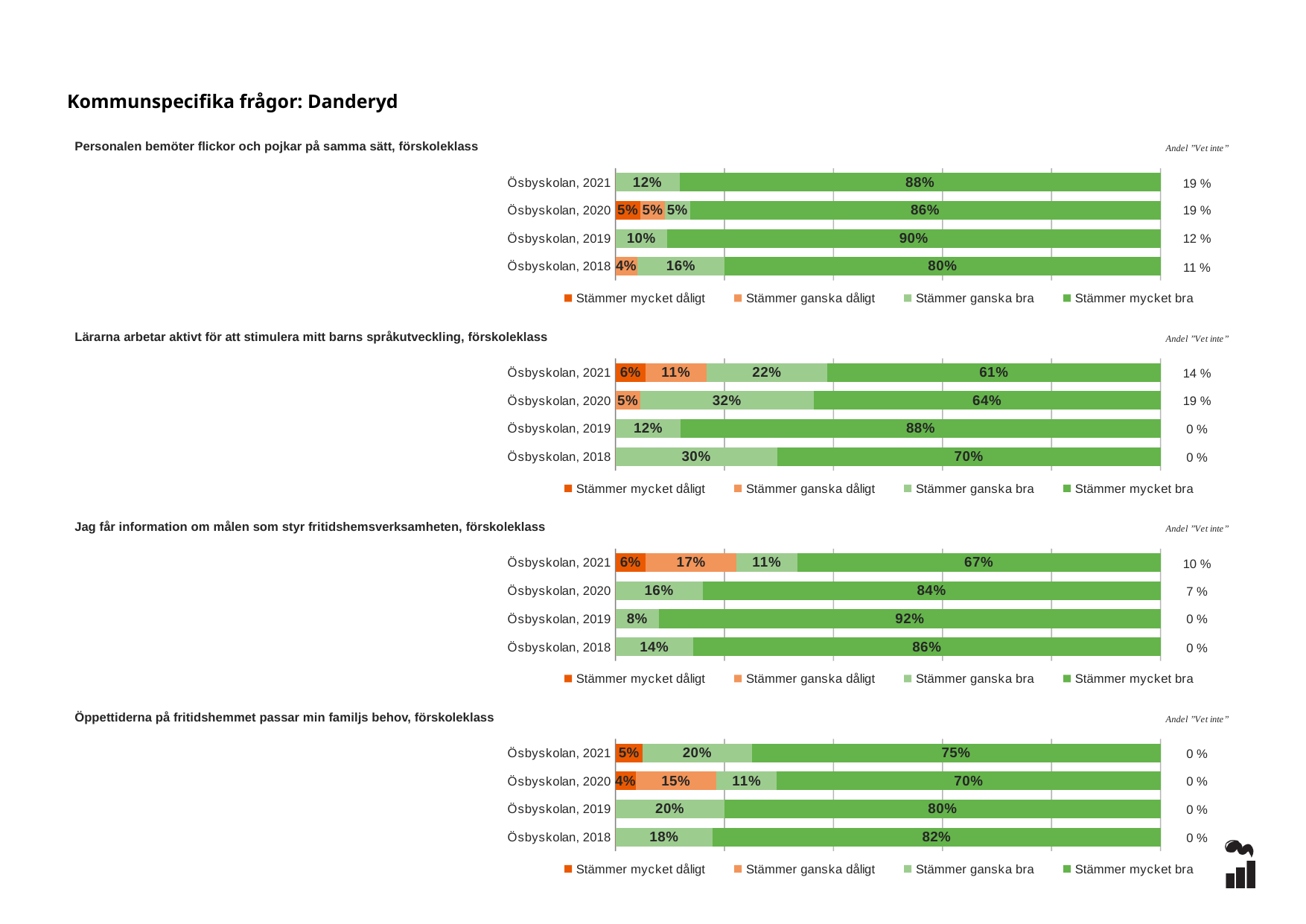
How many bars (years) are shown in the chart 'Personalen bemöter flickor och pojkar på samma sätt, förskoleklass'? 4 In the chart 'Personalen bemöter flickor och pojkar på samma sätt, förskoleklass', what is the value of 'Stämmer mycket bra' for Ösbyskolan, 2019? 90% In the chart 'Lärarna arbetar aktivt för att stimulera mitt barns språkutveckling, förskoleklass', what is the difference between the 'Stämmer mycket bra' values for Ösbyskolan, 2019 and Ösbyskolan, 2018? 18% What type of chart is 'Jag får information om målen som styr fritidshemsverksamheten, förskoleklass'? Stacked bar chart How many series does the legend list in the chart 'Öppettiderna på fritidshemmet passar min familjs behov, förskoleklass'? 4 In the chart 'Öppettiderna på fritidshemmet passar min familjs behov, förskoleklass', what is the value of 'Stämmer mycket bra' for Ösbyskolan, 2020? 70% In the chart 'Lärarna arbetar aktivt för att stimulera mitt barns språkutveckling, förskoleklass', what is the value of 'Stämmer ganska bra' for Ösbyskolan, 2020? 32% In the chart 'Öppettiderna på fritidshemmet passar min familjs behov, förskoleklass', what is the 'Andel Vet inte' value for Ösbyskolan, 2021? 0 % In the chart 'Lärarna arbetar aktivt för att stimulera mitt barns språkutveckling, förskoleklass', which year has the lowest 'Stämmer mycket bra' value? Ösbyskolan, 2021 In the chart 'Jag får information om målen som styr fritidshemsverksamheten, förskoleklass', which is larger: 'Stämmer mycket bra' for Ösbyskolan, 2020 or for Ösbyskolan, 2018? Ösbyskolan, 2018 In the chart 'Personalen bemöter flickor och pojkar på samma sätt, förskoleklass', which year has the highest 'Stämmer mycket bra' value? Ösbyskolan, 2019 In the chart 'Jag får information om målen som styr fritidshemsverksamheten, förskoleklass', what is the value of 'Stämmer ganska dåligt' for Ösbyskolan, 2021? 17%